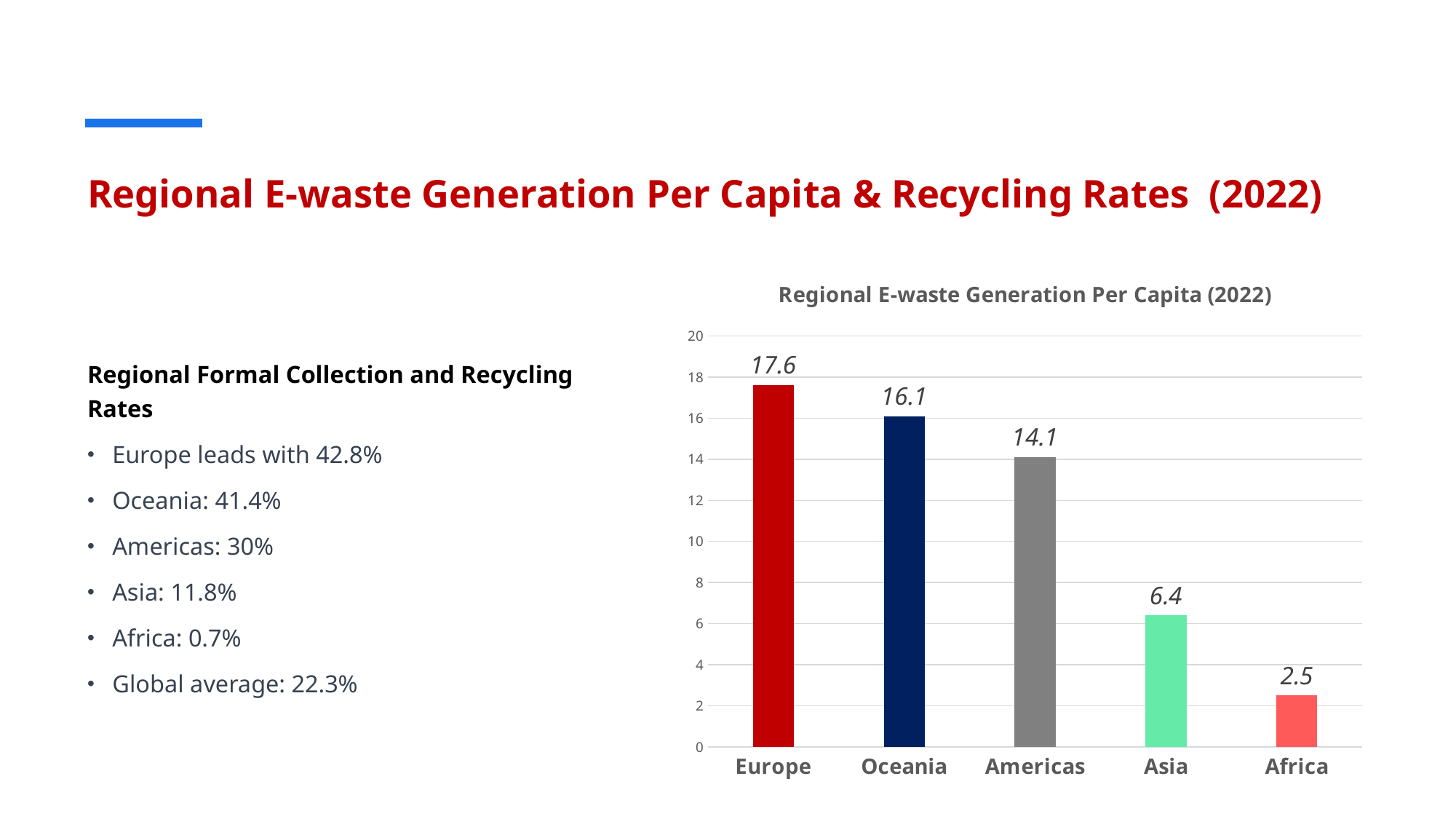
What is the value for Africa in the chart? 2.5 What is the title of the chart? Regional E-waste Generation Per Capita (2022) How many regions are shown in the chart? 5 What is the difference between the values for Europe and Oceania? 1.5 Which region has the lowest e-waste generation per capita in the chart? Africa Is the value for Asia greater or less than 8? less What is the difference between the values for Americas and Asia? 7.7 Which region has the highest e-waste generation per capita in the chart? Europe What kind of chart is shown on the slide? Bar chart Which is larger, the value for Oceania or the value for Americas? Oceania What is the value for Europe in the chart? 17.6 What is the value for Asia in the chart? 6.4